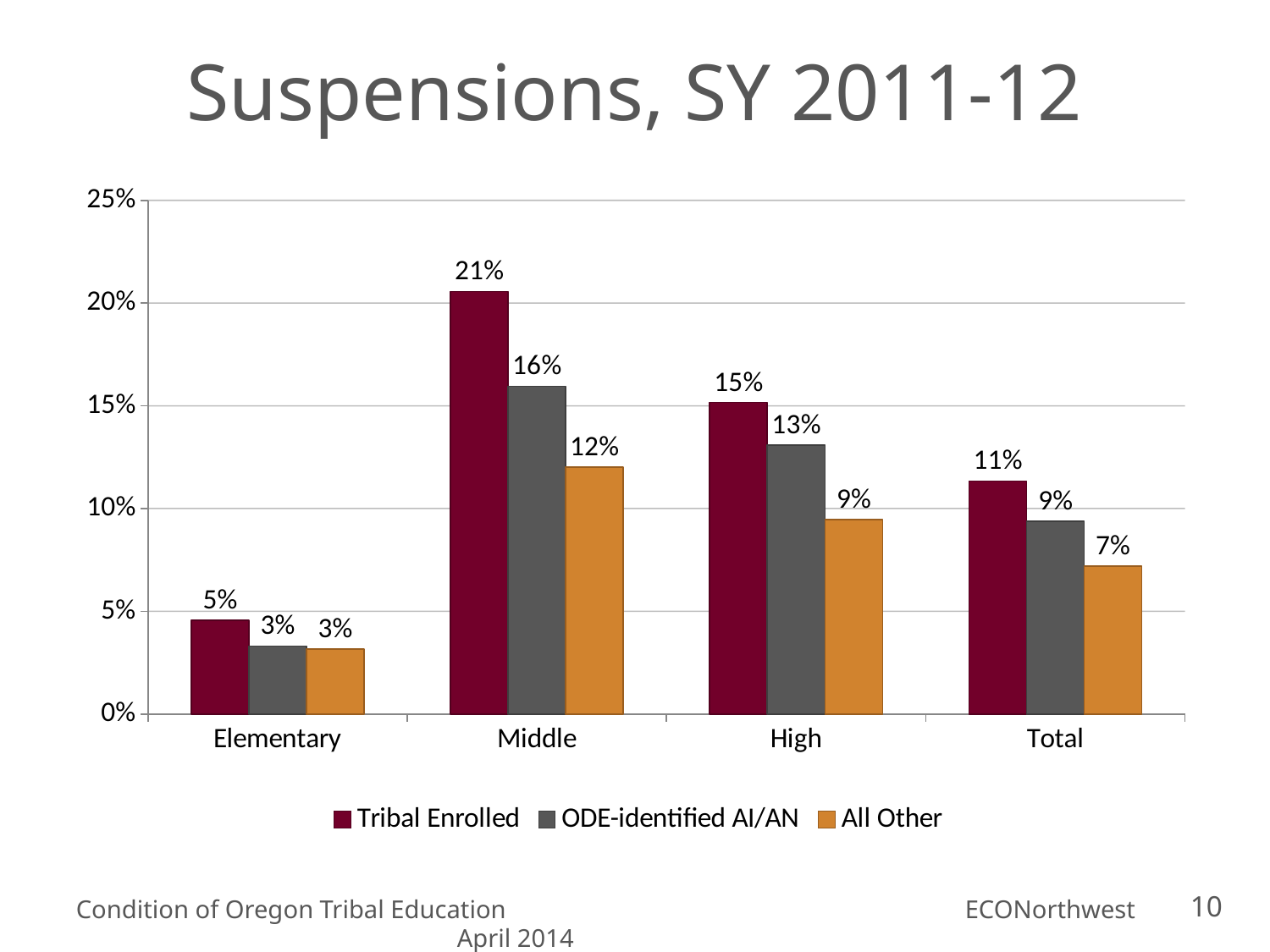
Which school level has the lowest All Other suspension rate? Elementary How many categories are shown on the x axis? 4 What is the difference between the Tribal Enrolled and All Other values at the Middle level? 9 percentage points Which is larger at the High level: the Tribal Enrolled value or the ODE-identified AI/AN value? Tribal Enrolled Is the Tribal Enrolled value at the Middle level greater or less than 20%? greater How many series does the legend list? 3 Which school level has the highest Tribal Enrolled suspension rate? Middle What kind of chart is shown on the slide? Bar chart What is the value for ODE-identified AI/AN students in the Total category? 9% What is the title of the chart? Suspensions, SY 2011-12 What is the suspension rate for Tribal Enrolled students at the Middle level? 21% What is the value for All Other students at the High level? 9%